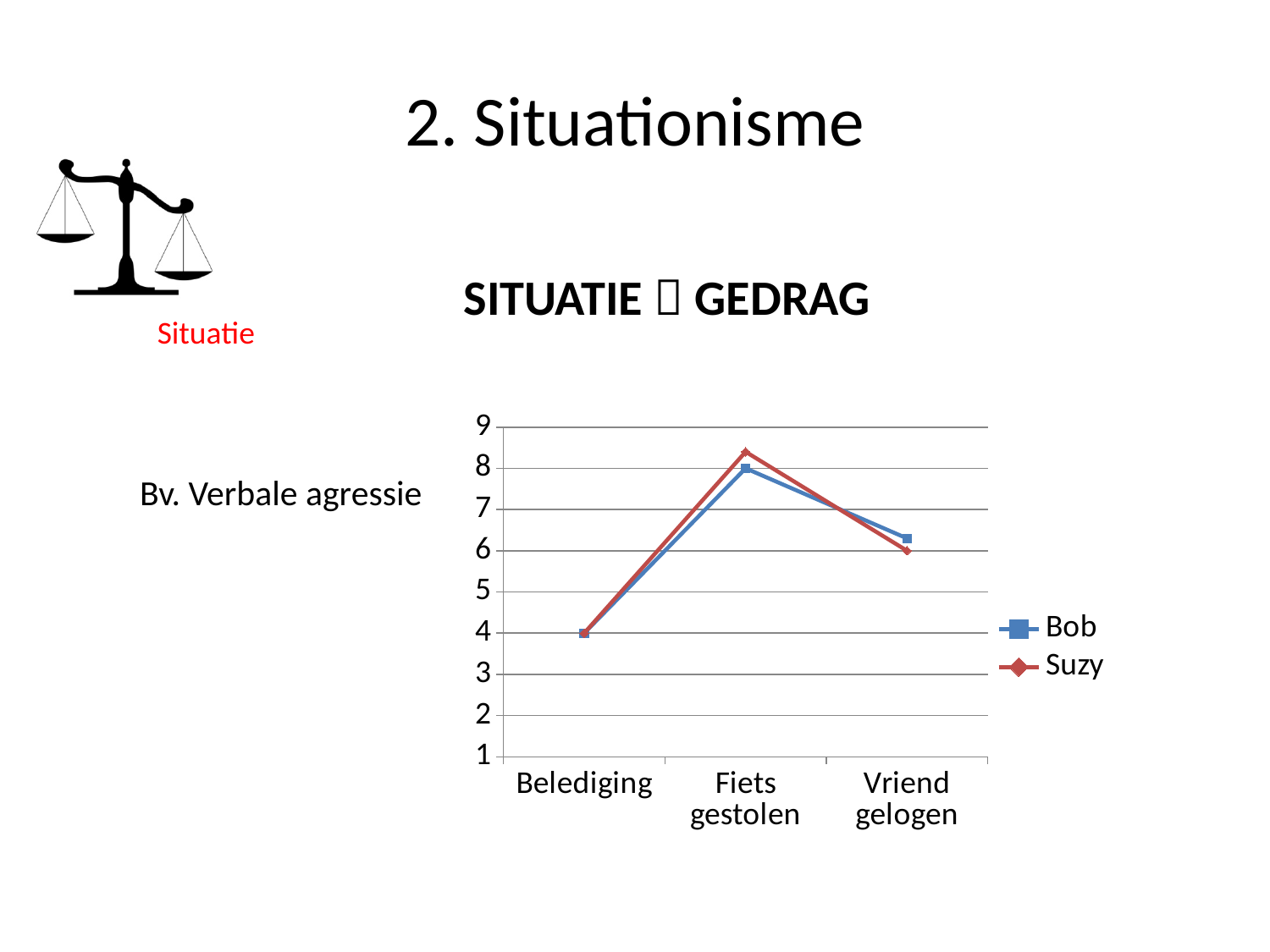
For which situation is Suzy's value lowest? Belediging How many categories are shown on the x axis of the chart? 3 Which series are listed in the chart's legend? Bob and Suzy Do Bob's values rise or fall from Fiets gestolen to Vriend gelogen? fall At Fiets gestolen, which series has the higher value, Bob or Suzy? Suzy For which situation is Bob's value highest? Fiets gestolen What is Suzy's value for Vriend gelogen? 6 Is Suzy's value for Fiets gestolen greater or less than 8? greater What is Bob's value for Fiets gestolen? 8 Is Bob's value for Vriend gelogen greater or less than 6? greater How many series does the chart's legend list? 2 What kind of chart is shown on the slide? line chart